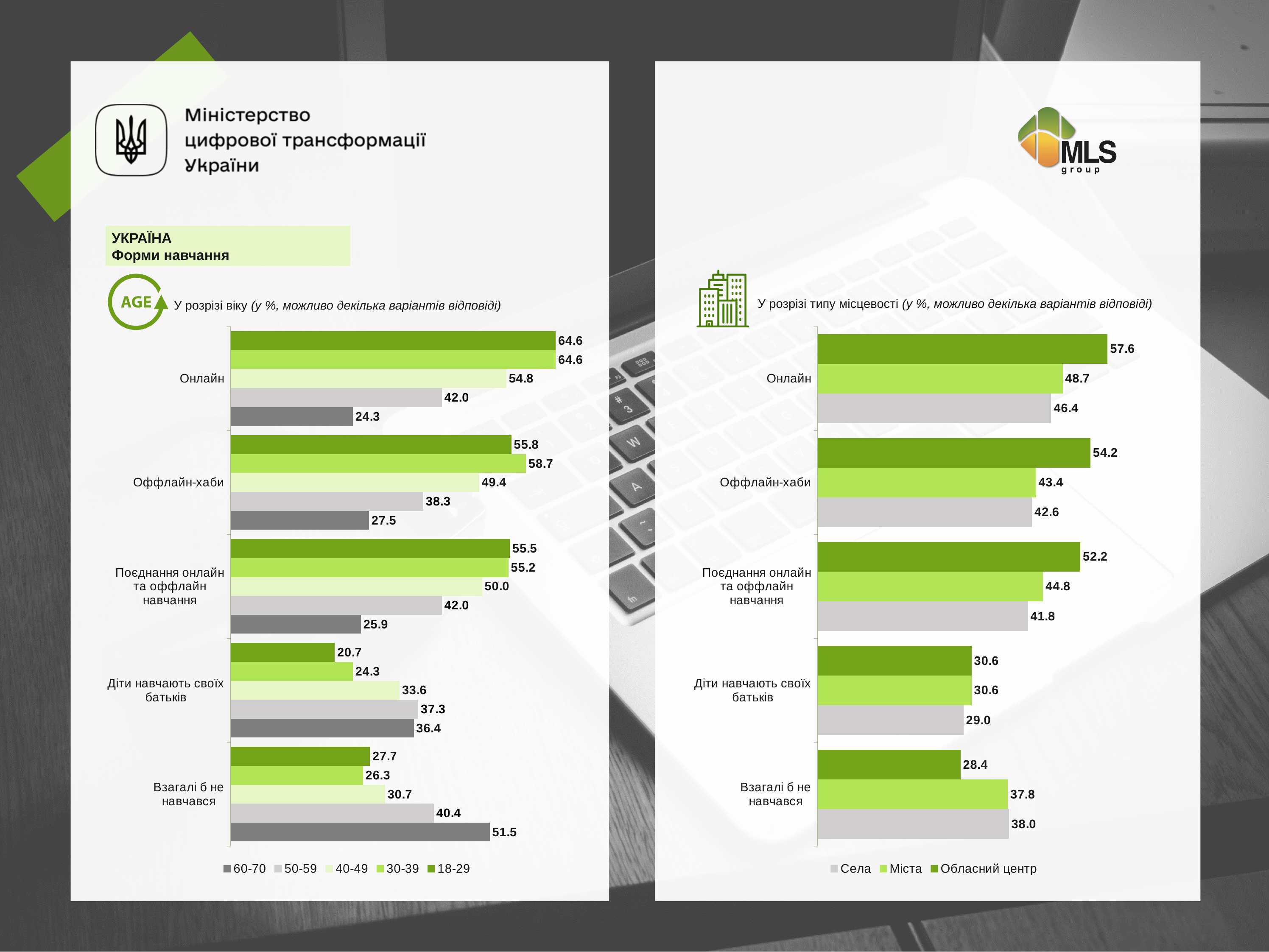
What kind of chart is the right chart (У розрізі типу місцевості)? Bar chart In the right chart (У розрізі типу місцевості), what is the value for Обласний центр for Онлайн? 57.6 In the right chart (У розрізі типу місцевості), what is the value for Села for Поєднання онлайн та оффлайн навчання? 41.8 In the left chart (У розрізі віку), how many series does the legend list? 5 In the left chart (У розрізі віку), which age group has the lowest value for Діти навчають своїх батьків? 18-29 In the right chart (У розрізі типу місцевості), how many categories are shown? 5 In the left chart (У розрізі віку), which age group has the highest value for Взагалі б не навчався? 60-70 In the right chart (У розрізі типу місцевості), which locality type has the highest value for Оффлайн-хаби? Обласний центр In the left chart (У розрізі віку), what is the difference between the 18-29 and 60-70 values for Онлайн? 40.3 In the left chart (У розрізі віку), what is the value for the 30-39 age group for Оффлайн-хаби? 58.7 In the left chart (У розрізі віку), what is the value for the 60-70 age group for Онлайн? 24.3 In the right chart (У розрізі типу місцевості), which is larger for Взагалі б не навчався: Міста or Обласний центр? Міста